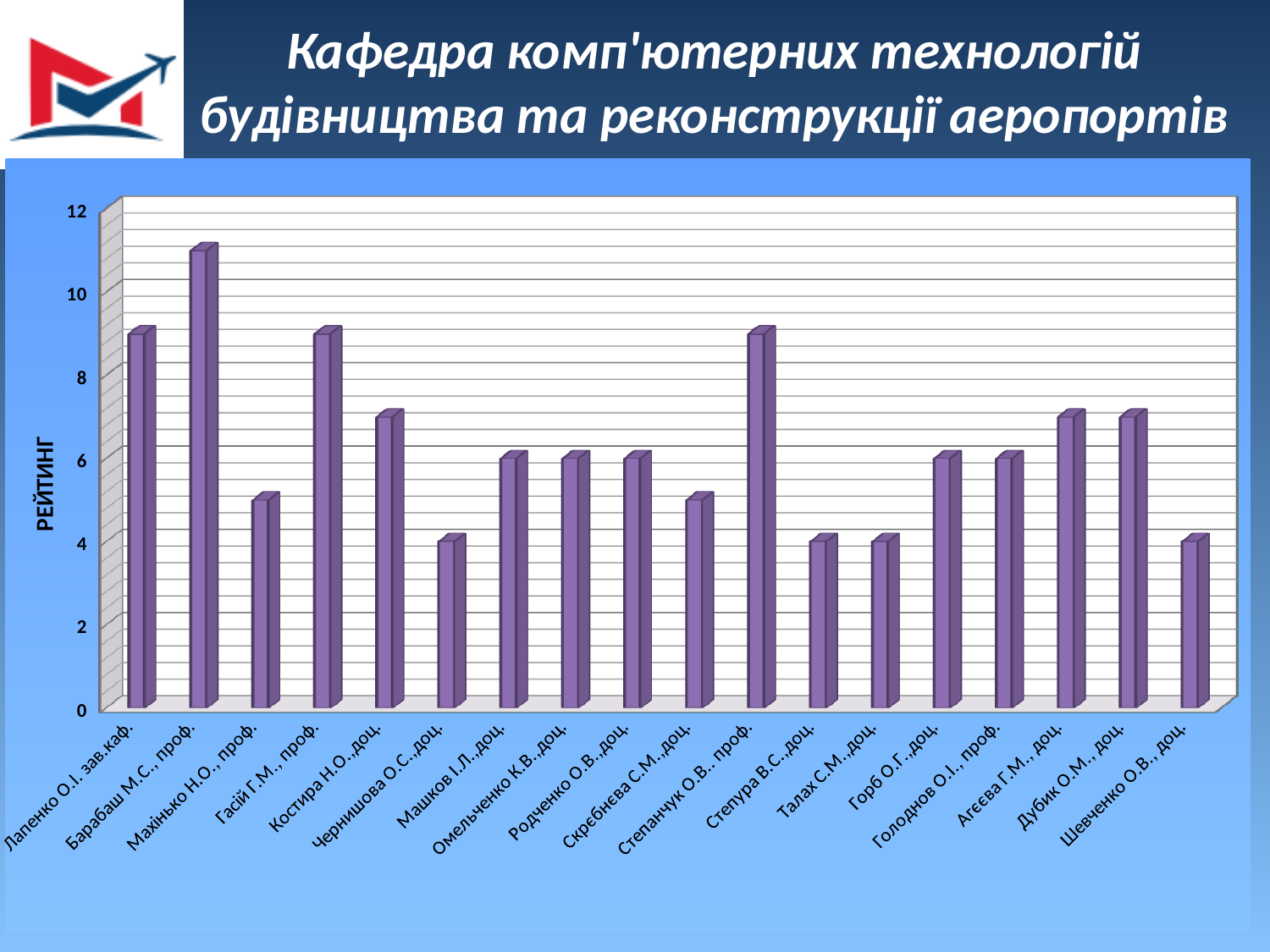
Is the value for Лапенко О.І. зав.каф. greater or less than 8? greater Which is larger, the value for Агєєва Г.М., доц. or the value for Шевченко О.В., доц.? Агєєва Г.М., доц. Is the value for Махінько Н.О., проф. greater or less than 6? less Which is larger, the value for Гасій Г.М., проф. or the value for Махінько Н.О., проф.? Гасій Г.М., проф. Which is larger, the value for Барабаш М.С., проф. or the value for Лапенко О.І. зав.каф.? Барабаш М.С., проф. What is the title of the vertical axis of the chart? РЕЙТИНГ Is the value for Барабаш М.С., проф. greater or less than 10? greater What kind of chart is shown on the slide? bar chart Which category has the highest value in the chart? Барабаш М.С., проф. How many categories (people) are shown on the x axis of the chart? 18